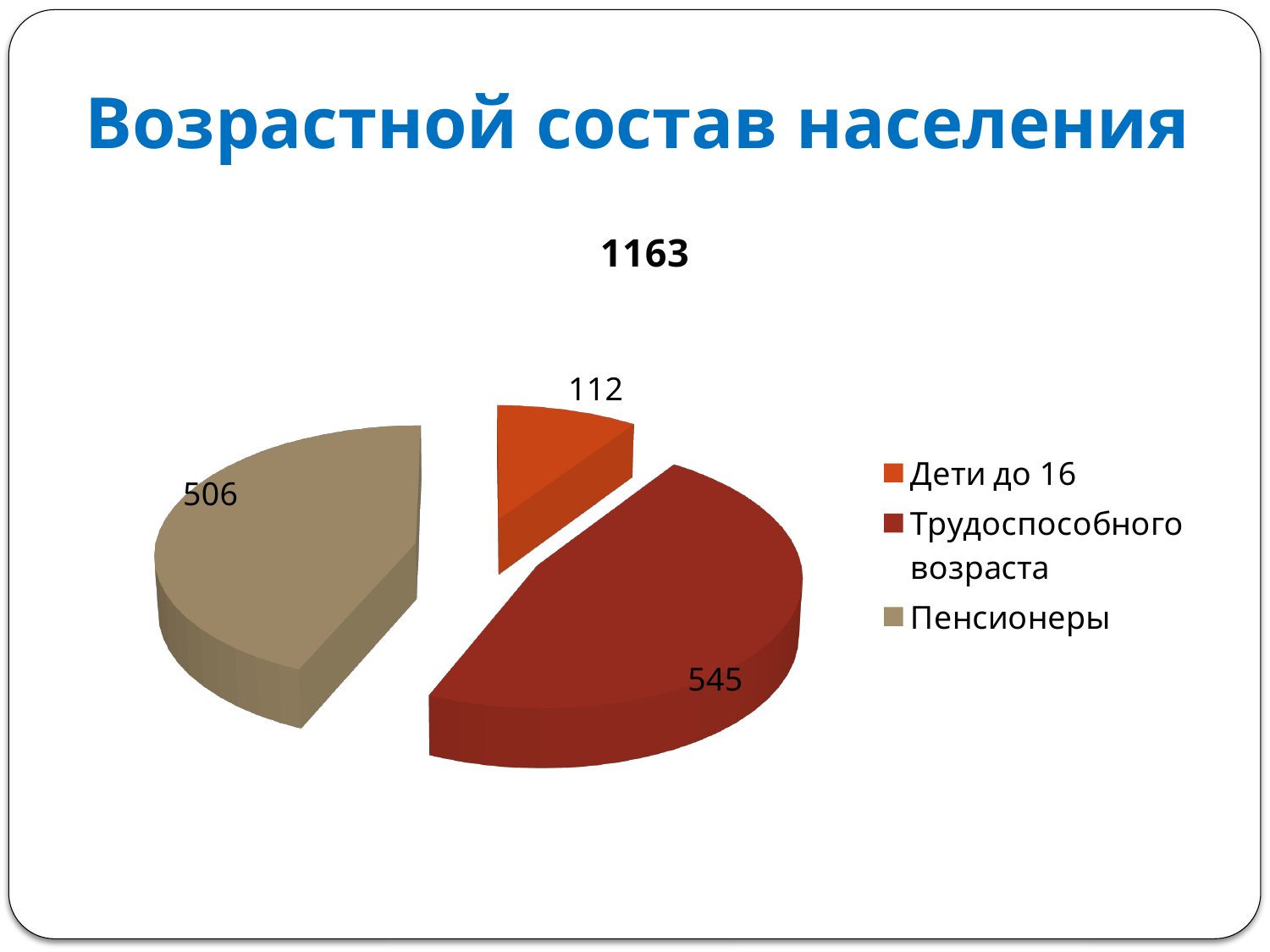
What is the difference between the values for Трудоспособного возраста and Пенсионеры? 39 What is the total of all slices in the pie chart? 1163 How many categories does the pie chart have? 3 Which is larger, the value for Пенсионеры or the value for Дети до 16? Пенсионеры Which category has the smallest slice of the pie? Дети до 16 What type of chart is shown on the slide? Pie chart What is the value for Трудоспособного возраста? 545 What is the title shown above the pie chart? 1163 What is the value for Пенсионеры? 506 What is the value for Дети до 16? 112 What is the difference between the values for Пенсионеры and Дети до 16? 394 Which category has the largest slice of the pie? Трудоспособного возраста